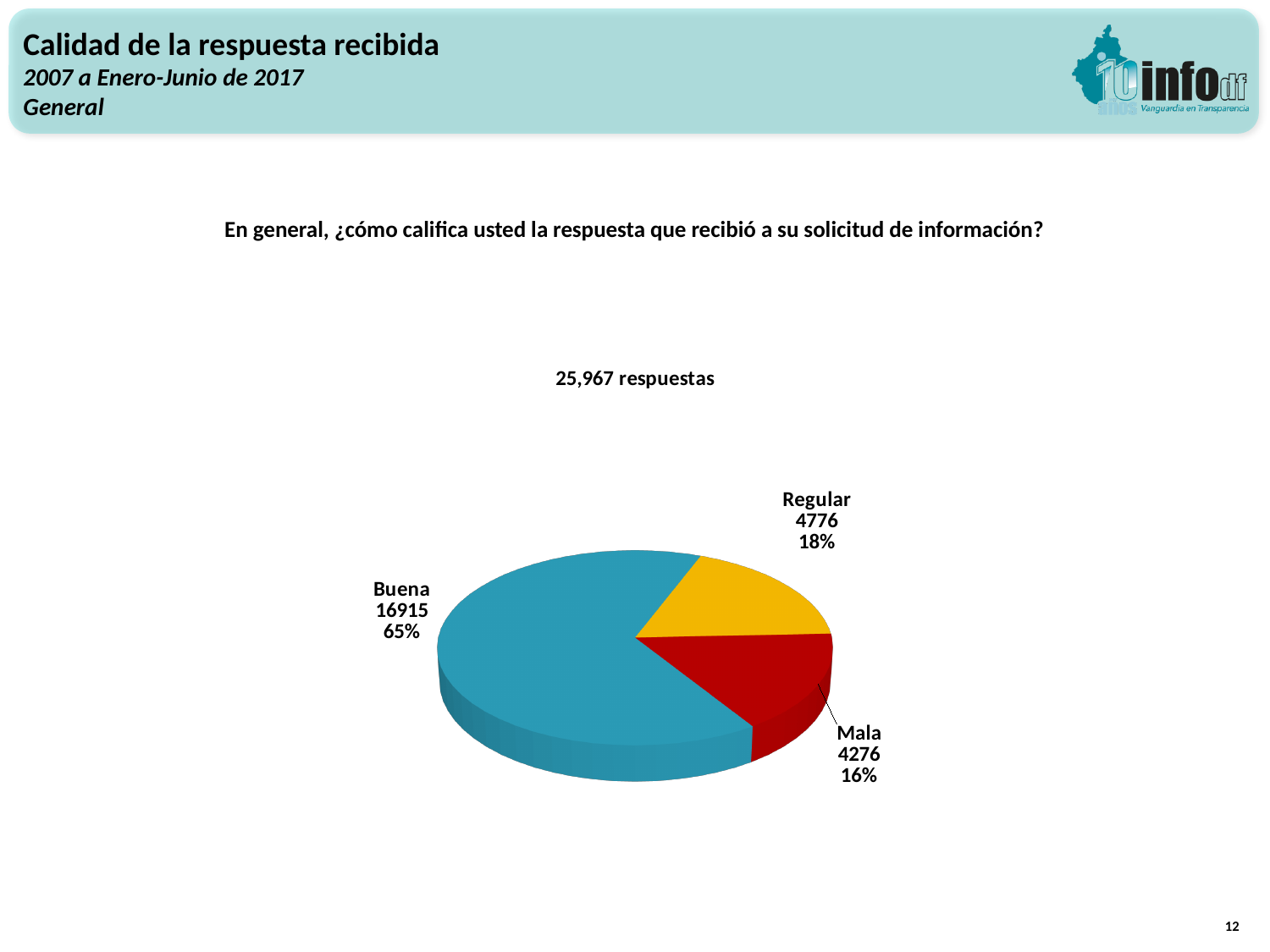
What is the number of responses for Buena? 16915 What is the number of responses for Regular? 4776 What kind of chart is shown on the slide? Pie chart Which category has the smallest slice? Mala What share of the pie does Mala represent? 16% What is the number of responses for Mala? 4276 What is the total number of responses stated above the chart? 25,967 respuestas Which has more responses, Regular or Mala? Regular Which category has the largest slice? Buena What share of the pie does Buena represent? 65% How many slices does the pie chart have? 3 What is the difference between the number of Regular and Mala responses? 500